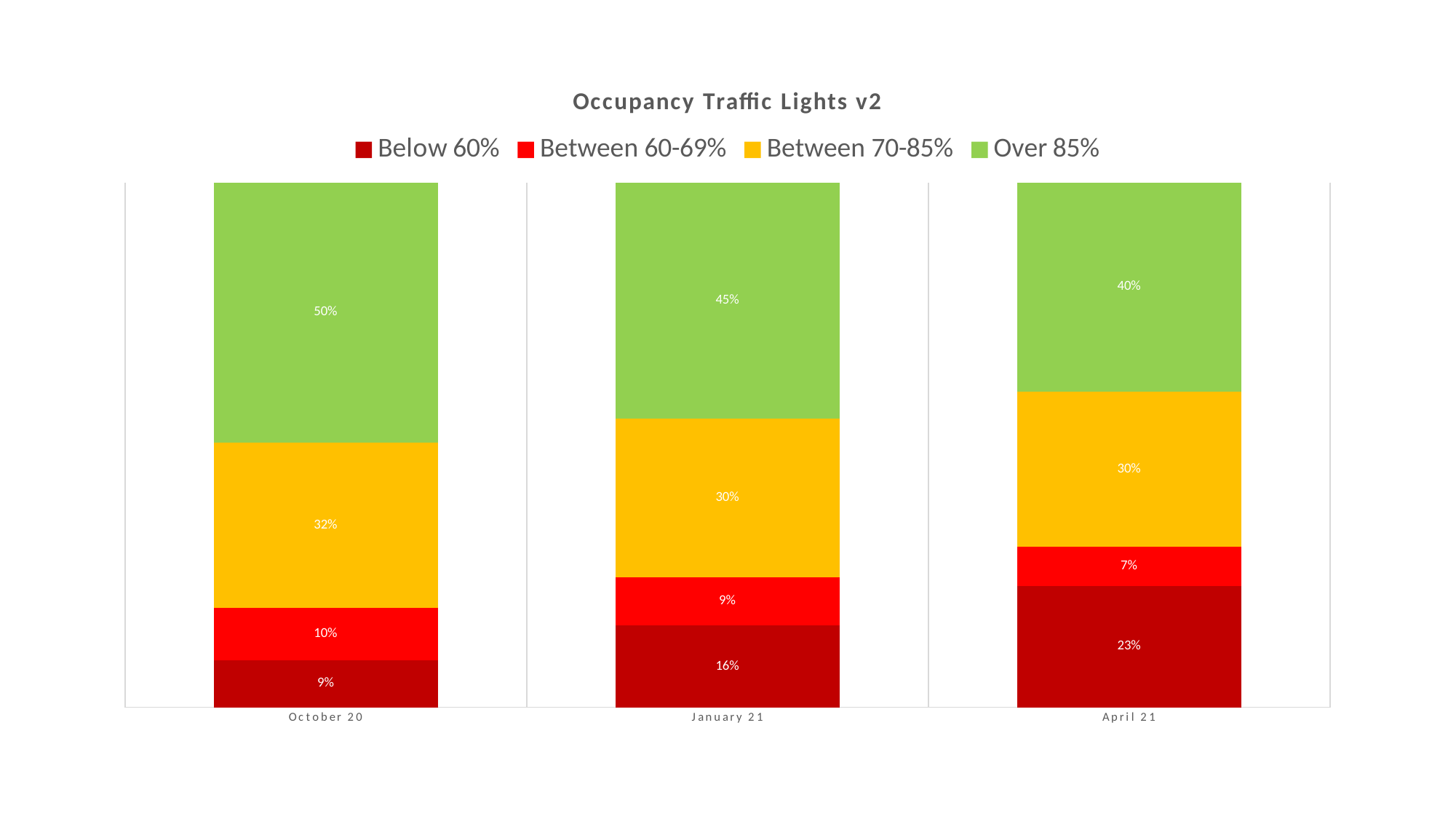
Does the Over 85% value rise or fall from October 20 to April 21? Fall What kind of chart is shown? Stacked bar chart Which category has the lowest value for Over 85%? April 21 How many categories are shown on the x axis? 3 What is the value for Between 60-69% in January 21? 9% How many series does the legend list? 4 What is the value for Between 70-85% in January 21? 30% Which category has the highest value for Below 60%? April 21 Which is larger: Between 60-69% in October 20 or Between 60-69% in April 21? October 20 What is the difference between the Over 85% values for October 20 and April 21? 10% What is the value for Over 85% in October 20? 50% What is the value for Below 60% in April 21? 23%